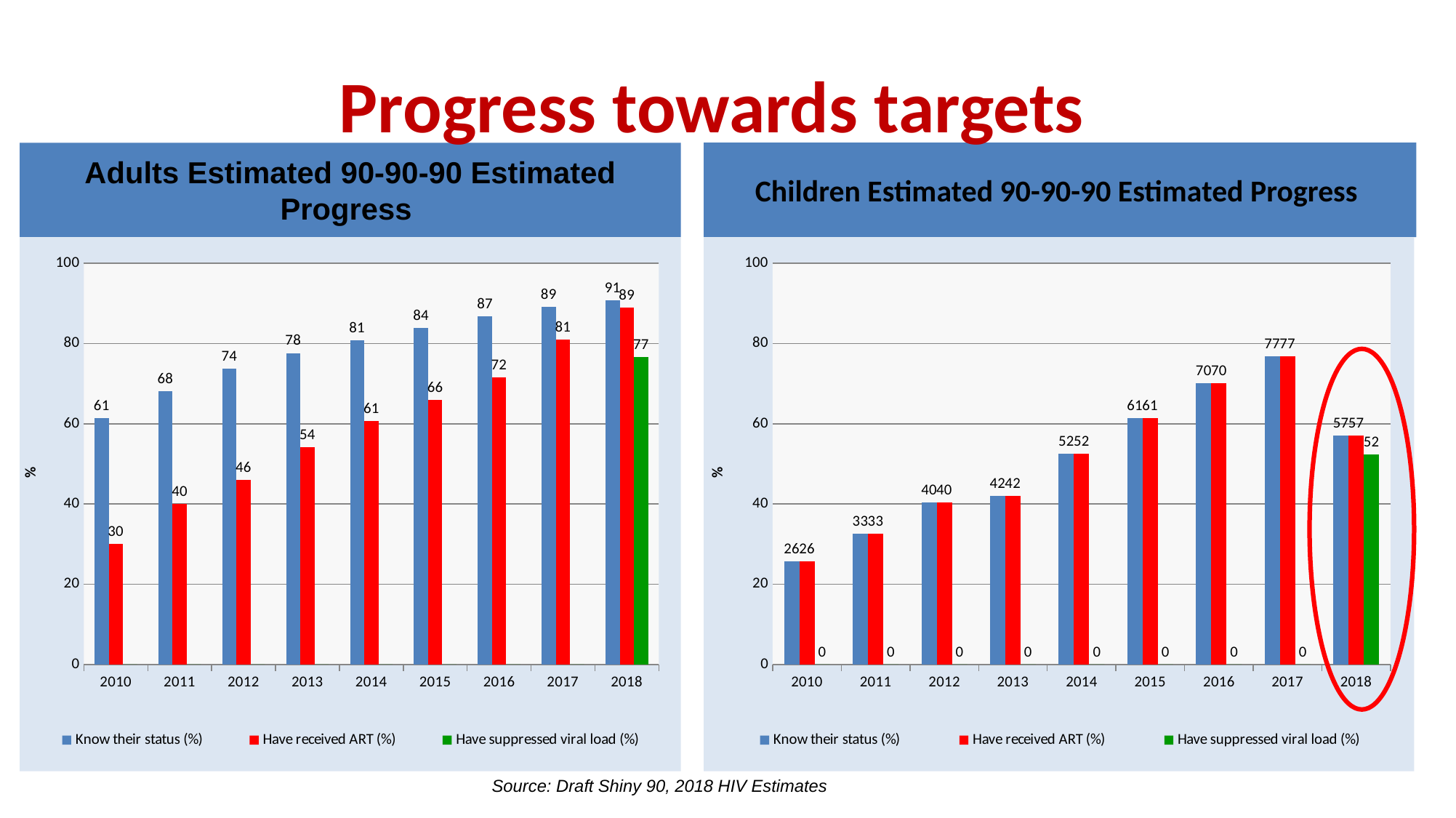
In the Adults Estimated 90-90-90 Estimated Progress chart, what is the value for Have suppressed viral load (%) in 2018? 77 How many years are shown on the x axis of the Adults Estimated 90-90-90 Estimated Progress chart? 9 In the Children Estimated 90-90-90 Estimated Progress chart, which year has the highest value for Know their status (%)? 2017 In the Adults Estimated 90-90-90 Estimated Progress chart, what is the difference between Know their status (%) and Have received ART (%) in 2012? 28 How many series does the legend of the Children Estimated 90-90-90 Estimated Progress chart list? 3 In the Children Estimated 90-90-90 Estimated Progress chart, what is the value for Have suppressed viral load (%) in 2018? 52 In the Adults Estimated 90-90-90 Estimated Progress chart, which year has the lowest value for Have received ART (%)? 2010 In the Adults Estimated 90-90-90 Estimated Progress chart, which year has the highest value for Know their status (%)? 2018 In the Adults Estimated 90-90-90 Estimated Progress chart, does Have received ART (%) rise or fall from 2010 to 2018? rise In the Adults Estimated 90-90-90 Estimated Progress chart, what is the value for Have received ART (%) in 2013? 54 In the Adults Estimated 90-90-90 Estimated Progress chart, what is the value for Know their status (%) in 2010? 61 In the Children Estimated 90-90-90 Estimated Progress chart, what is the value for Have suppressed viral load (%) in 2015? 0